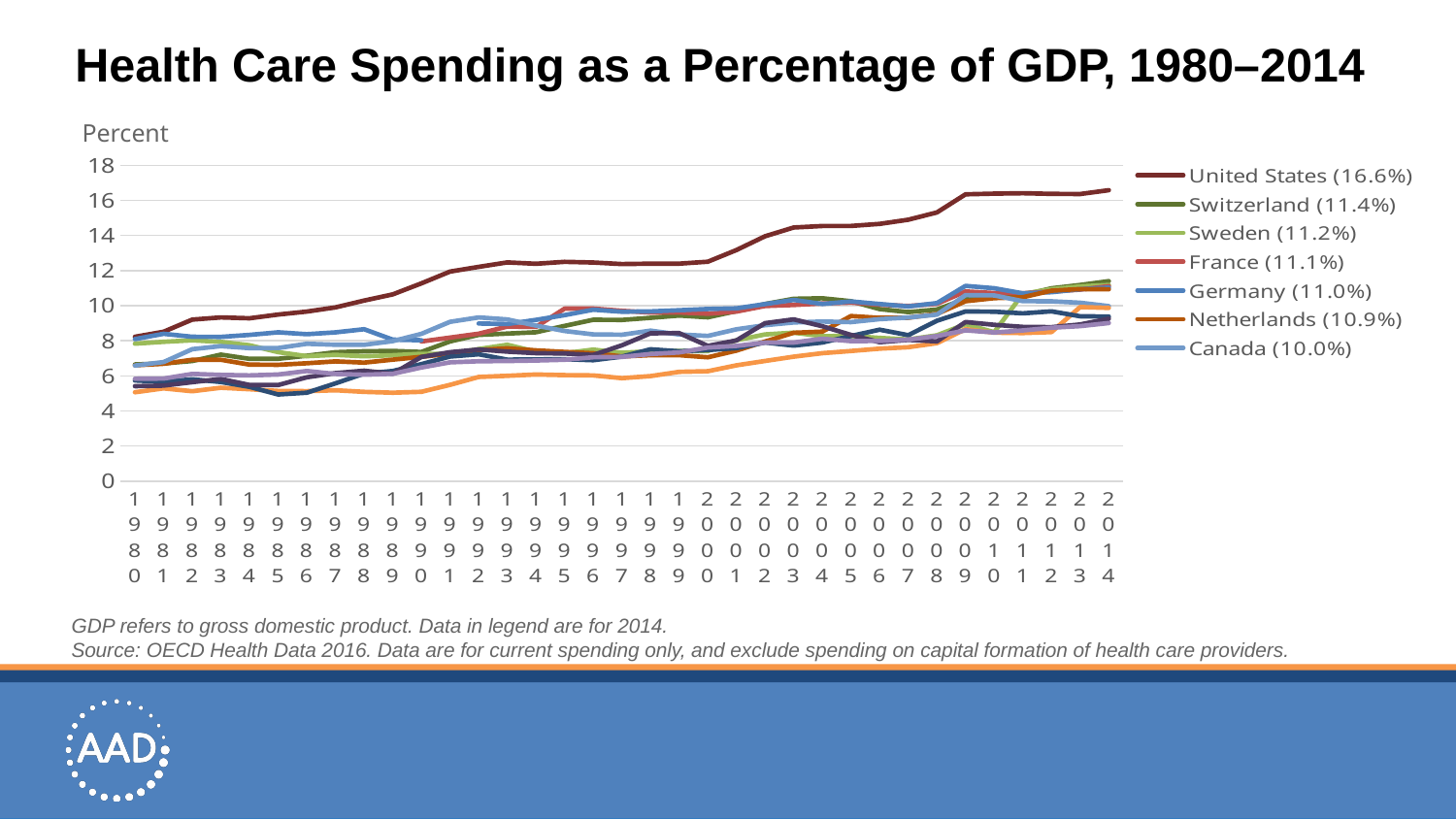
Which country in the legend has the lowest 2014 value? Canada What is the label on the vertical axis of the chart? Percent Does the United States line rise or fall from 1980 to 2014? rise By how many percentage points does the United States' 2014 value exceed Switzerland's 2014 value? 5.2 How many series does the legend list? 7 Is the value for the United States in 2000 greater or less than 14? less Which country in the legend has the highest 2014 value? United States According to the legend, what was Canada's health care spending as a percentage of GDP in 2014? 10.0% According to the legend, what was health care spending as a percentage of GDP for the United States in 2014? 16.6% What kind of chart is shown on the slide? line chart Which had the higher 2014 value, Sweden or France? Sweden Is the value for the United States in 1980 greater or less than 10? less